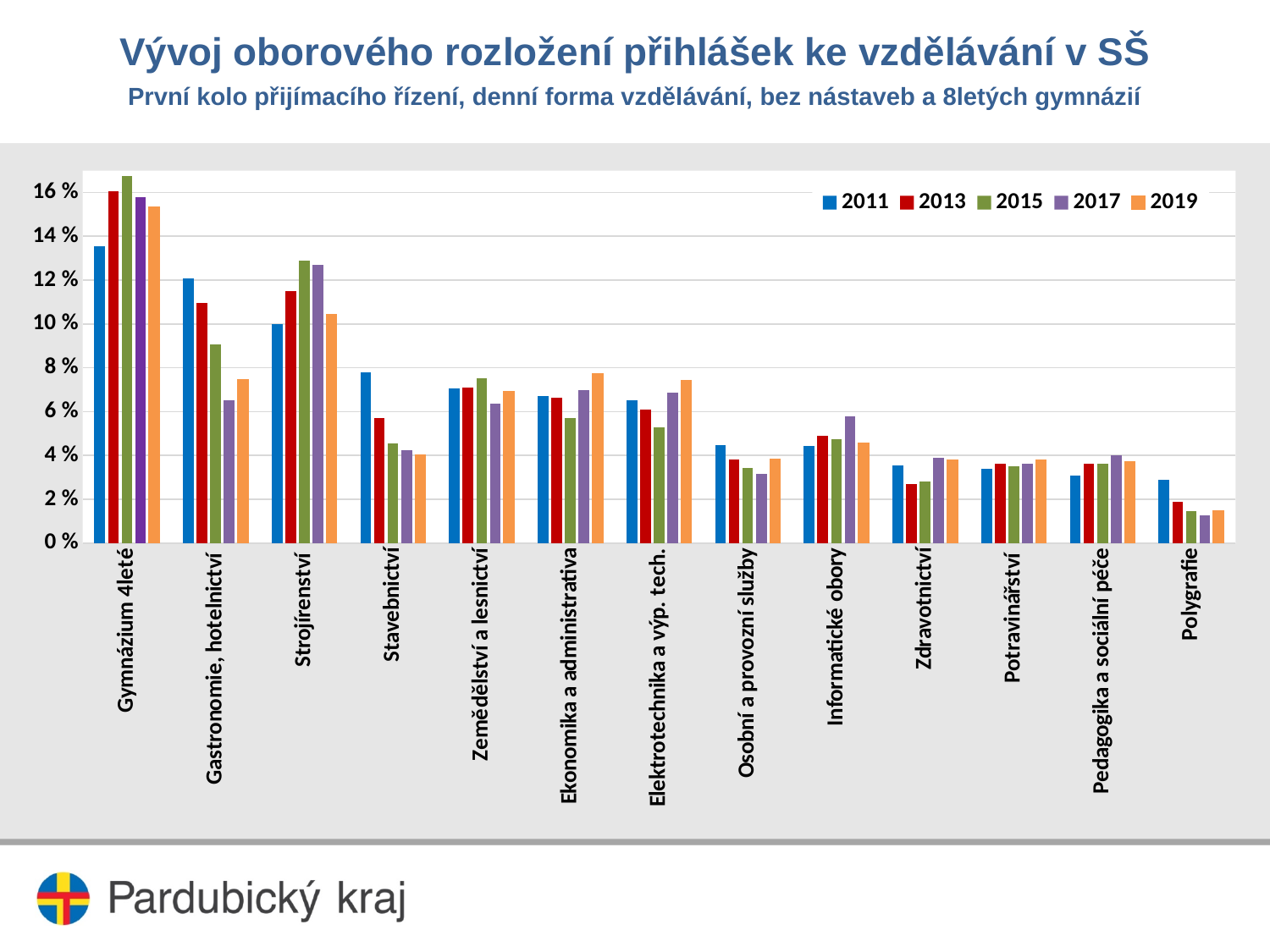
Which year is shown in orange in the legend? 2019 Is the value for Gymnázium 4leté in 2015 greater or less than 16 %? greater Which is larger for 2011: Gymnázium 4leté or Strojírenství? Gymnázium 4leté How many series does the legend list? 5 How many categories (fields of study) are shown on the x axis? 13 What kind of chart is shown on the slide? bar chart Which category has the lowest bars in the chart? Polygrafie Do the values for Stavebnictví rise or fall from 2011 to 2019? fall Is the value for Strojírenství in 2019 greater or less than 10 %? greater Which category has the highest bar in the chart? Gymnázium 4leté Is the value for Polygrafie in 2017 greater or less than 2 %? less